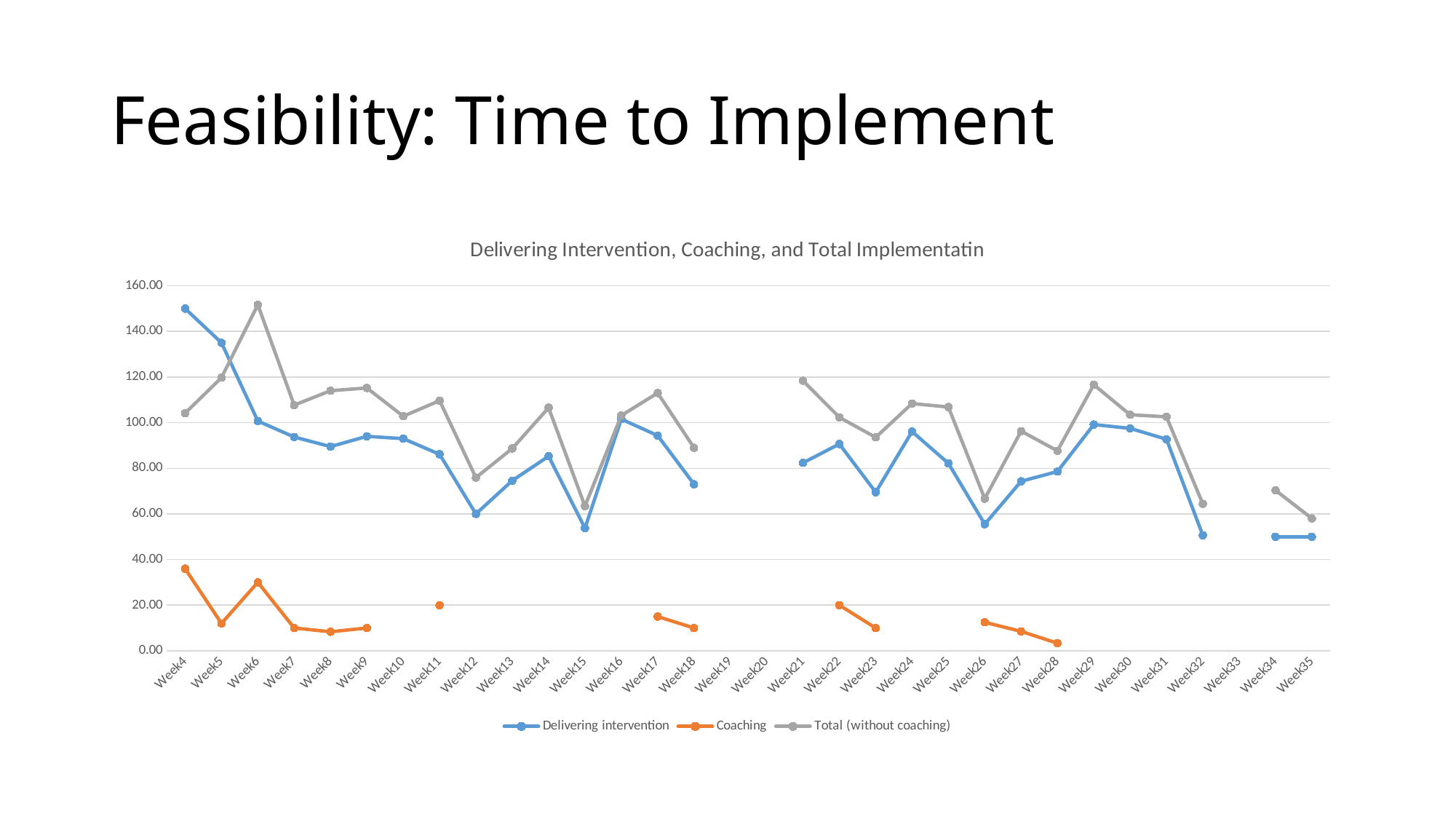
What is the title of the chart? Delivering Intervention, Coaching, and Total Implementatin Which colour is used for the Coaching series? Orange In which week is the Delivering intervention series highest? Week4 Is the value for Delivering intervention at Week4 greater or less than 140? greater Is the value for Coaching at Week5 greater or less than 20? less Which is larger: Total (without coaching) at Week6 or at Week4? Week6 Does the Delivering intervention series rise or fall from Week4 to Week6? Fall How many week categories are shown on the x axis? 32 In which week is the Coaching series lowest? Week28 How many series does the legend list? 3 In which week is the Total (without coaching) series highest? Week6 What kind of chart is shown on the slide? Line chart